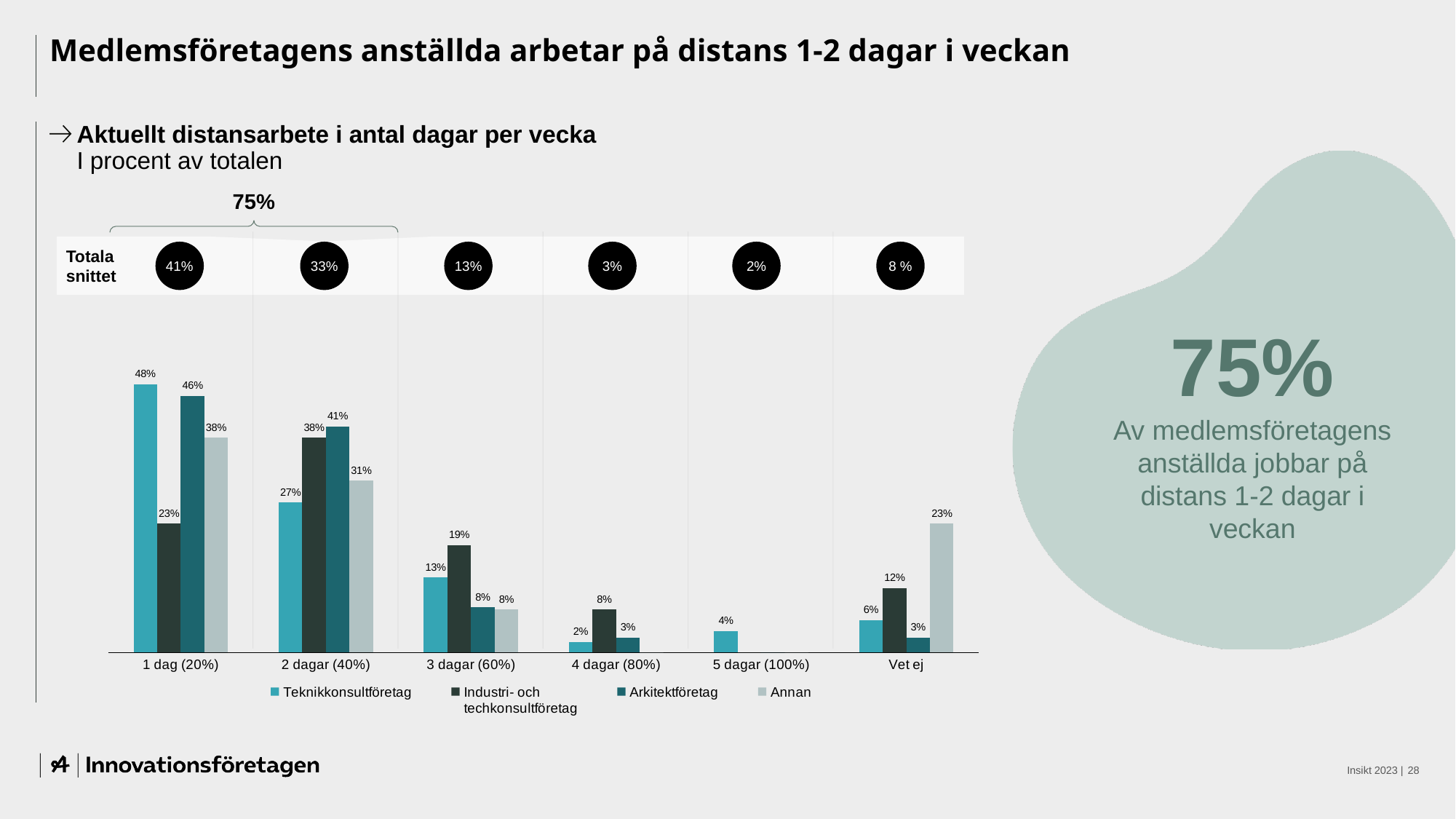
How many categories are shown on the x axis? 6 What is the value for Teknikkonsultföretag in the '1 dag (20%)' category? 48% In the '2 dagar (40%)' category, which is larger: Industri- och techkonsultföretag or Annan? Industri- och techkonsultföretag Which series has the highest value in the '1 dag (20%)' category? Teknikkonsultföretag How many series does the legend list? 4 What is the value for Annan in the 'Vet ej' category? 23% What is the difference between Industri- och techkonsultföretag and Teknikkonsultföretag in the '3 dagar (60%)' category? 6% What kind of chart is shown on the slide? bar chart What percentage is highlighted in the large text on the right side of the slide? 75% What is the value for Arkitektföretag in the '2 dagar (40%)' category? 41% What is the 'Totala snittet' value shown for '3 dagar (60%)'? 13% Which series has the lowest value in the 'Vet ej' category? Arkitektföretag